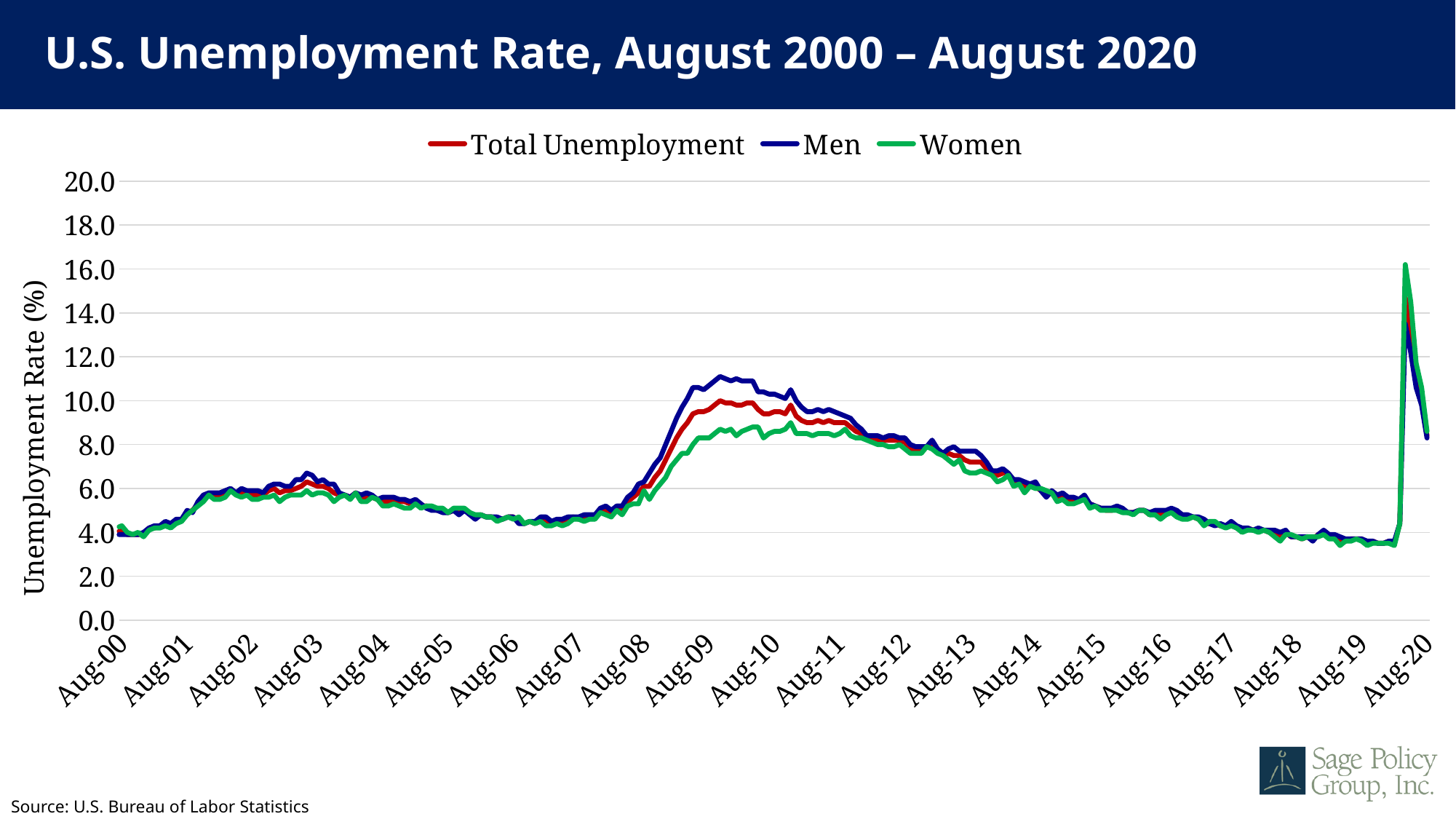
How many series does the legend list? 3 Which series is highest around Aug-09 to Aug-10? Men Which series reaches the highest value at the spike near Aug-20? Women What is the title of the chart? U.S. Unemployment Rate, August 2000 – August 2020 Is the peak value for Men around Aug-10 greater or less than 10.0? greater Which series is drawn in green? Women Is the value for Total Unemployment at Aug-19 greater or less than 6.0? less How many labels are shown on the x axis? 21 What kind of chart is shown on the slide? Line chart Do the values for Total Unemployment rise or fall between Aug-10 and Aug-19? fall Around Aug-09, which is larger: the value for Men or the value for Women? Men Is the value for Women around Aug-10 greater or less than 10.0? less